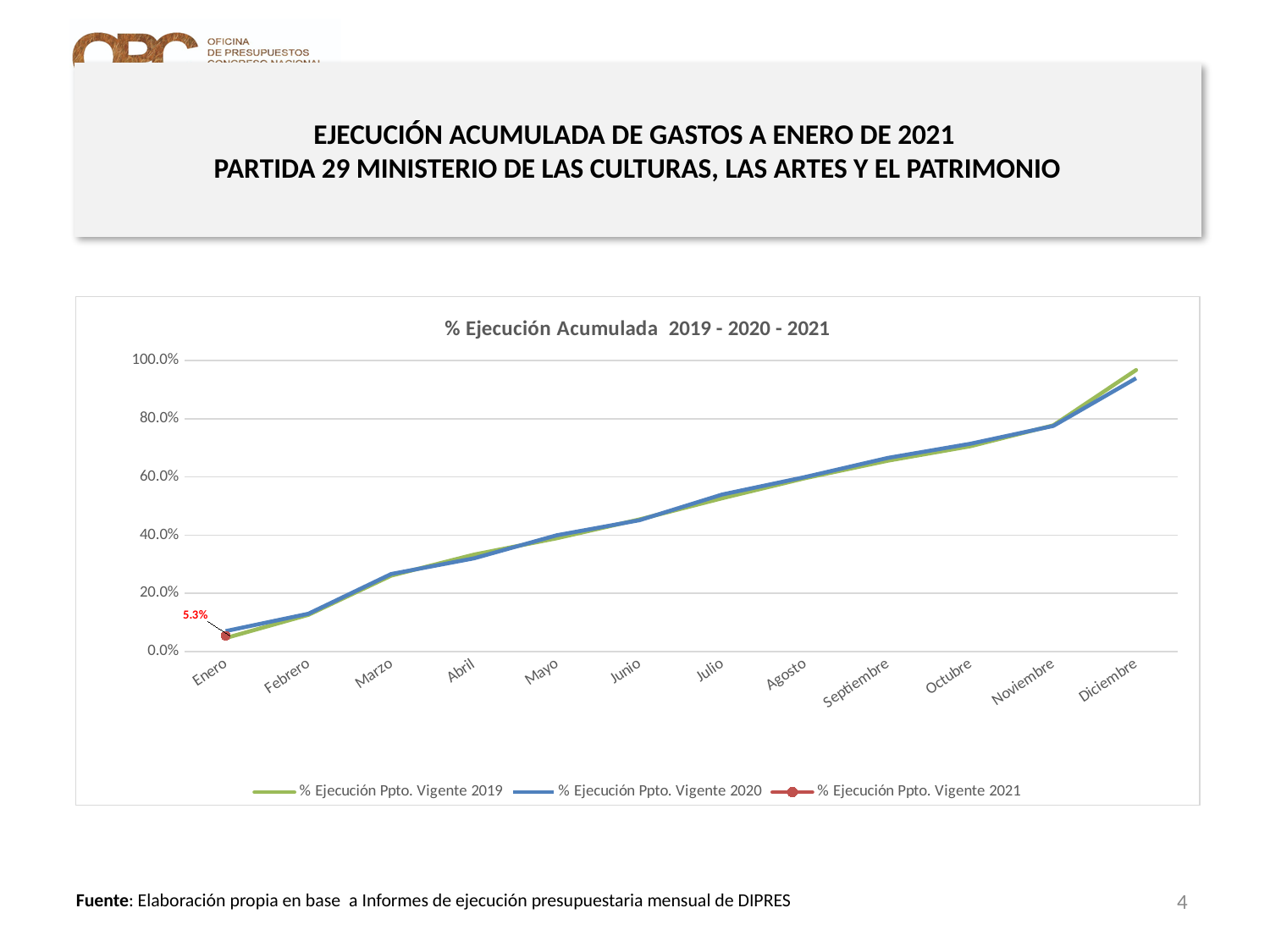
Do the values for % Ejecución Ppto. Vigente 2020 rise or fall from Enero to Diciembre? rise Is the value for % Ejecución Ppto. Vigente 2020 in Junio greater or less than 60.0%? less Is the value for % Ejecución Ppto. Vigente 2019 in Noviembre greater or less than 60.0%? greater Is the value for % Ejecución Ppto. Vigente 2019 in Enero greater or less than 20.0%? less Which month has the lowest value for % Ejecución Ppto. Vigente 2020? Enero How many months are shown along the x axis? 12 What is the title of the chart? % Ejecución Acumulada 2019 - 2020 - 2021 What kind of chart is shown on the slide? line chart Which month has the highest value for % Ejecución Ppto. Vigente 2019? Diciembre What is the value for % Ejecución Ppto. Vigente 2021 in Enero? 5.3% How many series does the legend list? 3